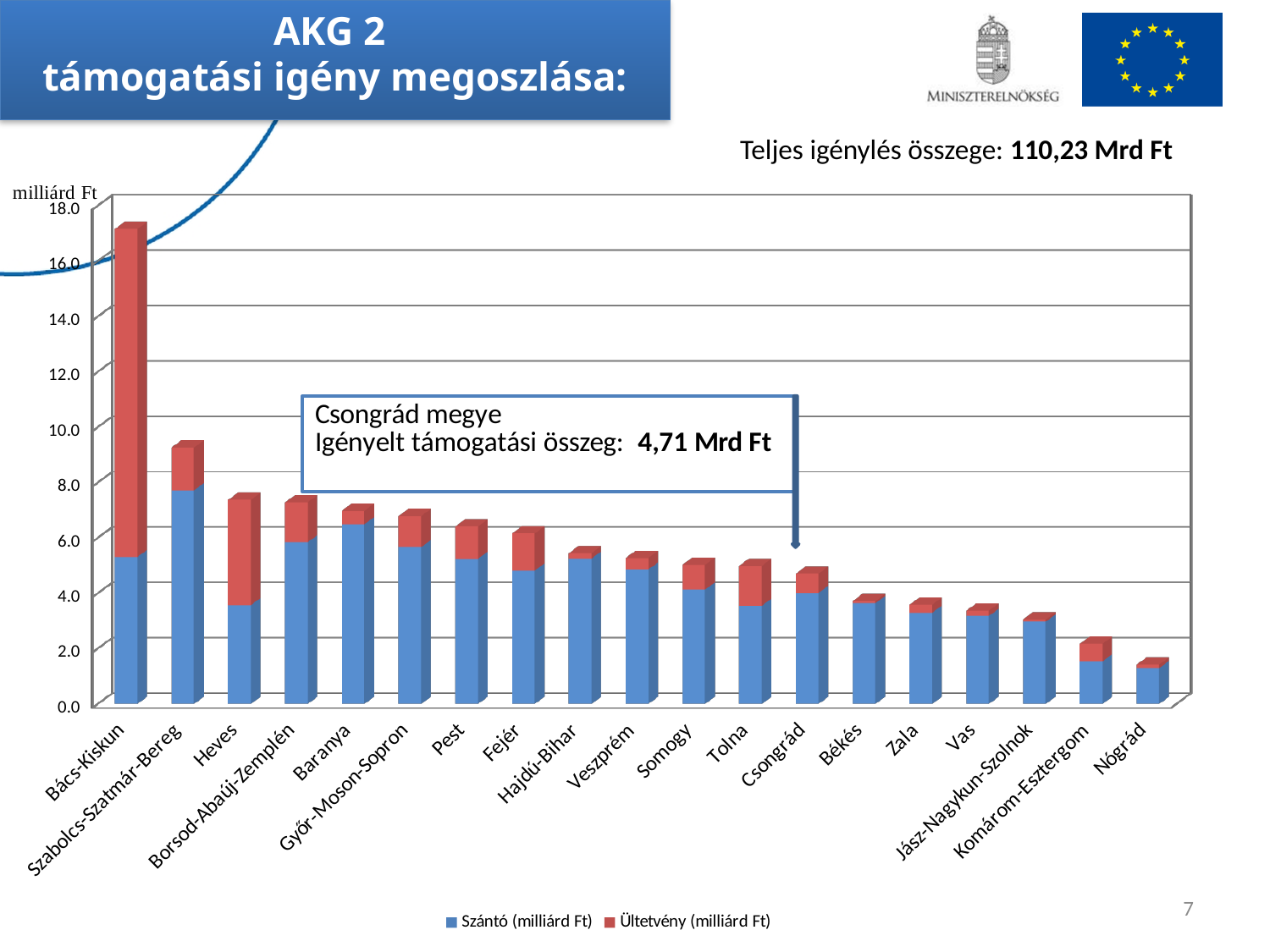
Is the total value for Bács-Kiskun greater or less than 16.0? greater Is the total value for Heves greater or less than 8.0? less What kind of chart is shown on the slide? bar chart Which county has the lowest total bar? Nógrád Which colour represents the Ültetvény (milliárd Ft) series in the legend? red Which county has the larger total bar, Bács-Kiskun or Szabolcs-Szatmár-Bereg? Bács-Kiskun How many series does the legend list? 2 What is the requested support amount (igényelt támogatási összeg) for Csongrád megye shown in the callout? 4,71 Mrd Ft How many counties (categories) are shown on the x axis? 19 For Bács-Kiskun, which series segment is larger, Szántó or Ültetvény? Ültetvény Which county has the highest total bar? Bács-Kiskun Do the total bar heights rise or fall from left to right along the x axis? fall